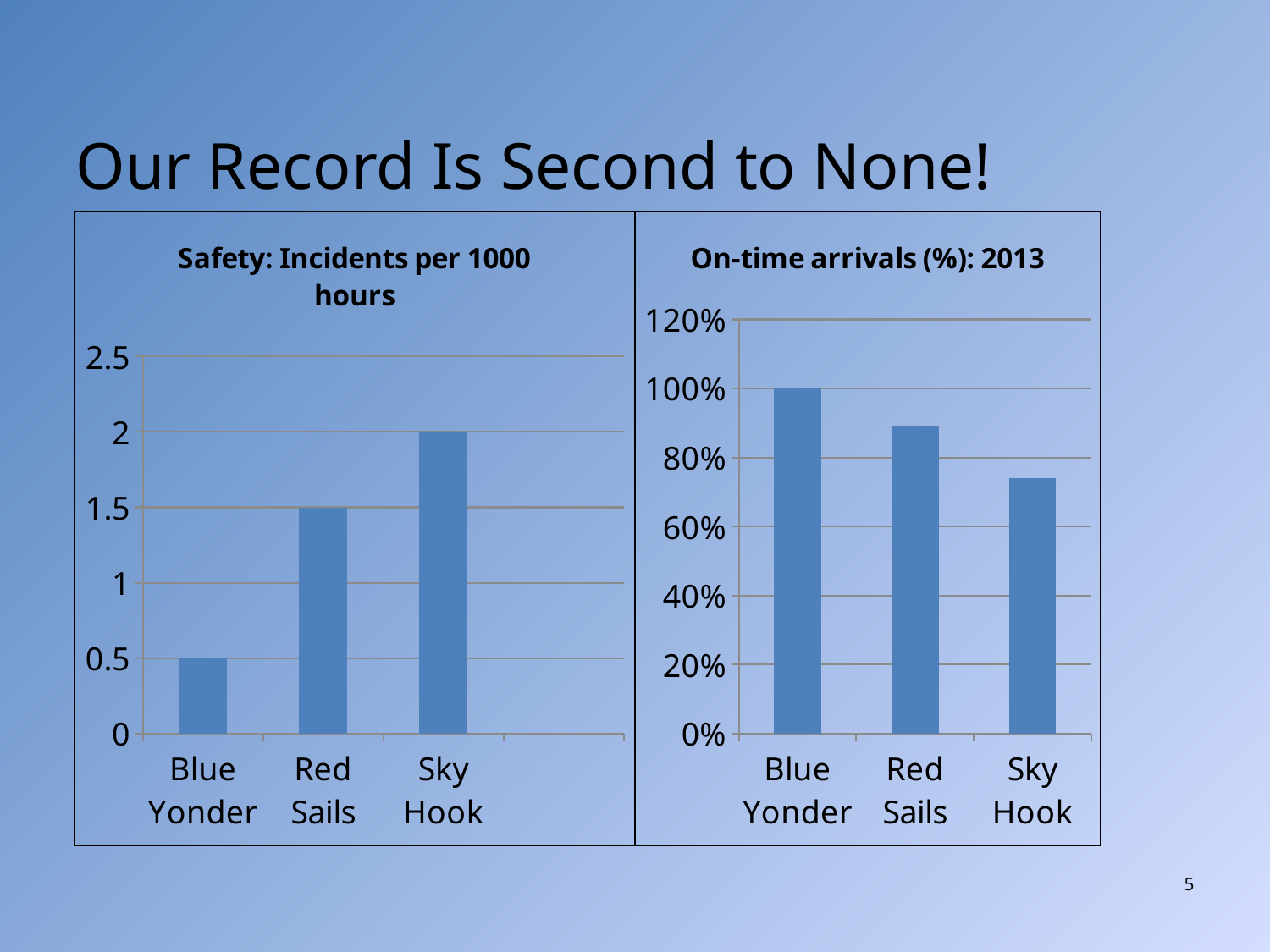
In the 'On-time arrivals (%): 2013' chart, do the values rise or fall from Blue Yonder to Sky Hook? fall In the 'Safety: Incidents per 1000 hours' chart, which category has the lowest value? Blue Yonder In the 'Safety: Incidents per 1000 hours' chart, which category has the highest value? Sky Hook In the 'Safety: Incidents per 1000 hours' chart, what is the value for Blue Yonder? 0.5 In the 'On-time arrivals (%): 2013' chart, is the value for Red Sails greater or less than 80%? greater How many categories are shown in the 'Safety: Incidents per 1000 hours' chart? 3 What kind of chart is the 'Safety: Incidents per 1000 hours' chart on the left? bar chart In the 'On-time arrivals (%): 2013' chart, which category has the highest value? Blue Yonder In the 'On-time arrivals (%): 2013' chart, is the value for Sky Hook greater or less than 80%? less In the 'Safety: Incidents per 1000 hours' chart, what is the value for Sky Hook? 2 In the 'Safety: Incidents per 1000 hours' chart, what is the difference between the values for Sky Hook and Blue Yonder? 1.5 In the 'On-time arrivals (%): 2013' chart, what is the value for Blue Yonder? 100%